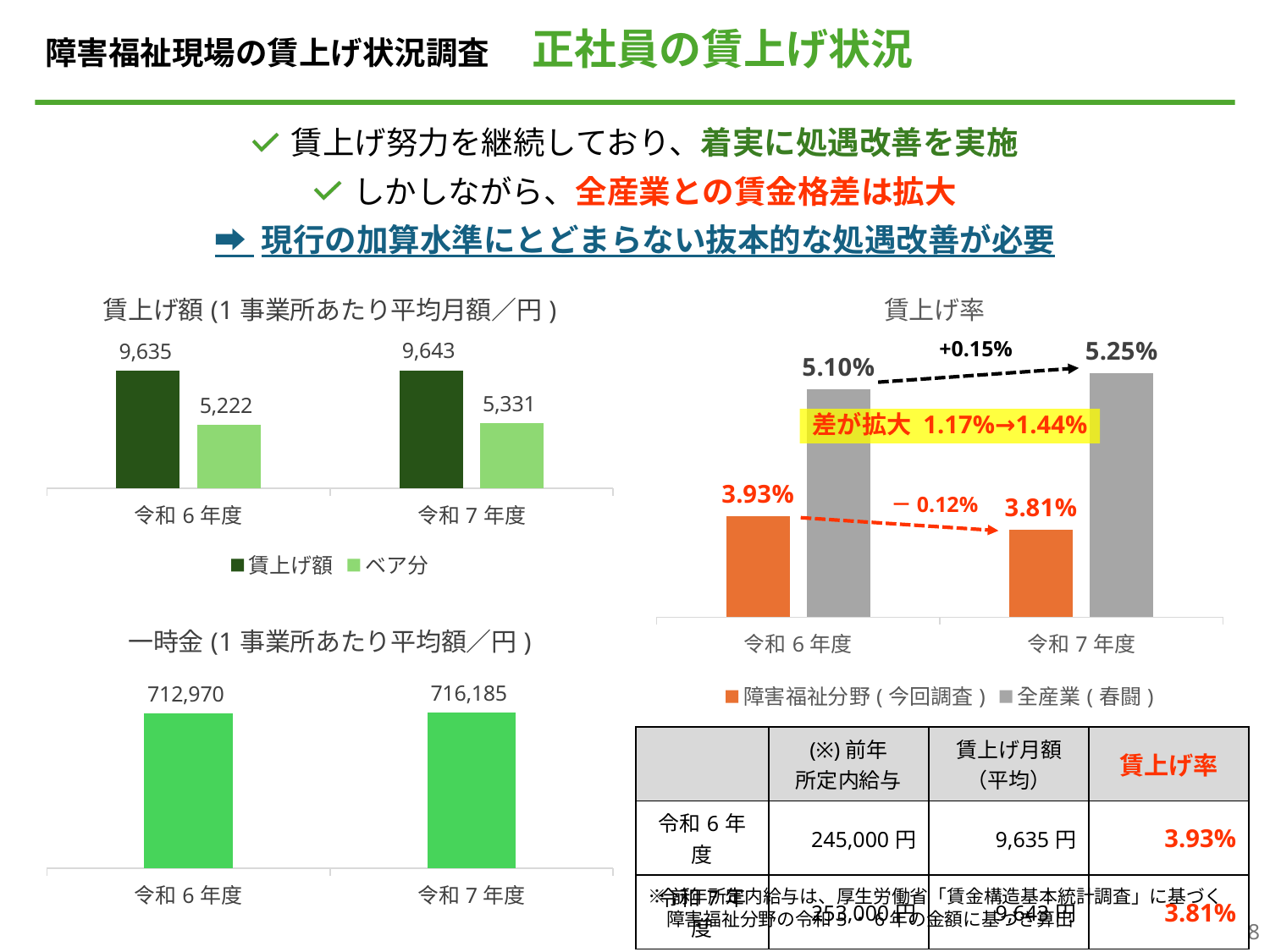
In the 賃上げ率 chart, what is the difference between the 全産業(春闘) and 障害福祉分野(今回調査) values for 令和7年度? 1.44% In the 賃上げ額 chart, what is the difference between the 賃上げ額 values for 令和7年度 and 令和6年度? 8 In the 一時金 chart, which year has the higher value? 令和7年度 In the 一時金 chart, what is the difference between the 令和7年度 and 令和6年度 values? 3,215 In the 賃上げ率 chart, what is the 全産業(春闘) value for 令和7年度? 5.25% In the 賃上げ額 chart, what is the ベア分 value for 令和7年度? 5,331 In the 賃上げ額 chart, how many series does the legend list? 2 What kind of chart is the 一時金 chart? bar chart In the 賃上げ率 chart, what is the 障害福祉分野(今回調査) value for 令和6年度? 3.93% In the 賃上げ額 chart, what is the 賃上げ額 value for 令和6年度? 9,635 In the 一時金 chart, what is the value for 令和7年度? 716,185 In the 賃上げ率 chart, does the 障害福祉分野(今回調査) value rise or fall from 令和6年度 to 令和7年度? fall